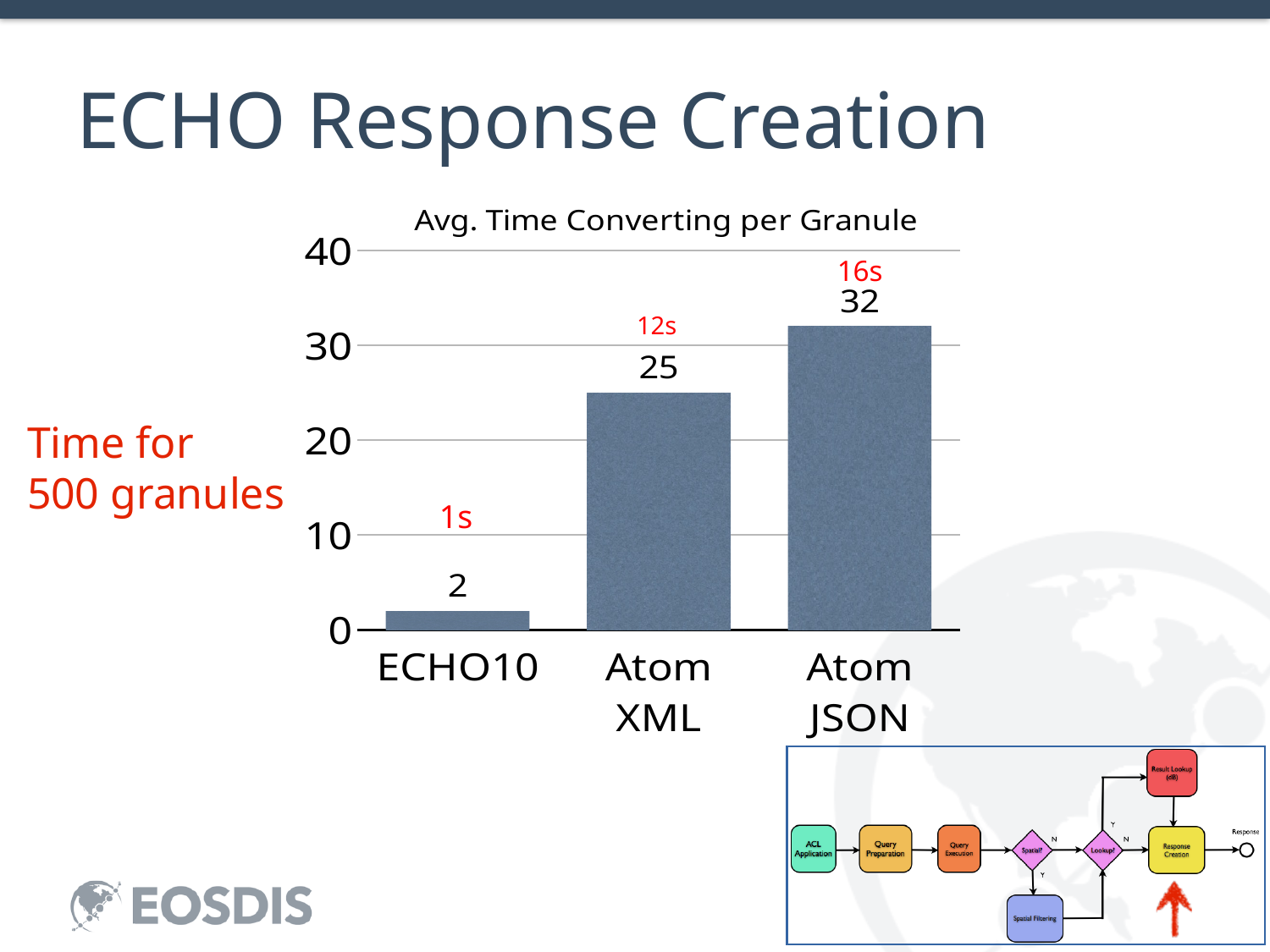
What is the value for Atom JSON in the Avg. Time Converting per Granule chart? 32 What kind of chart is shown on the slide? bar chart What is the value for ECHO10 in the Avg. Time Converting per Granule chart? 2 Which category has the highest value in the Avg. Time Converting per Granule chart? Atom JSON What is the difference between the values for Atom XML and ECHO10? 23 Is the value for Atom JSON greater or less than 30? greater What is the title of the chart on the slide? Avg. Time Converting per Granule Which category has the lowest value in the Avg. Time Converting per Granule chart? ECHO10 What is the difference between the values for Atom JSON and Atom XML? 7 How many categories are shown in the Avg. Time Converting per Granule chart? 3 Which is larger, the value for Atom XML or the value for ECHO10? Atom XML What is the value for Atom XML in the Avg. Time Converting per Granule chart? 25